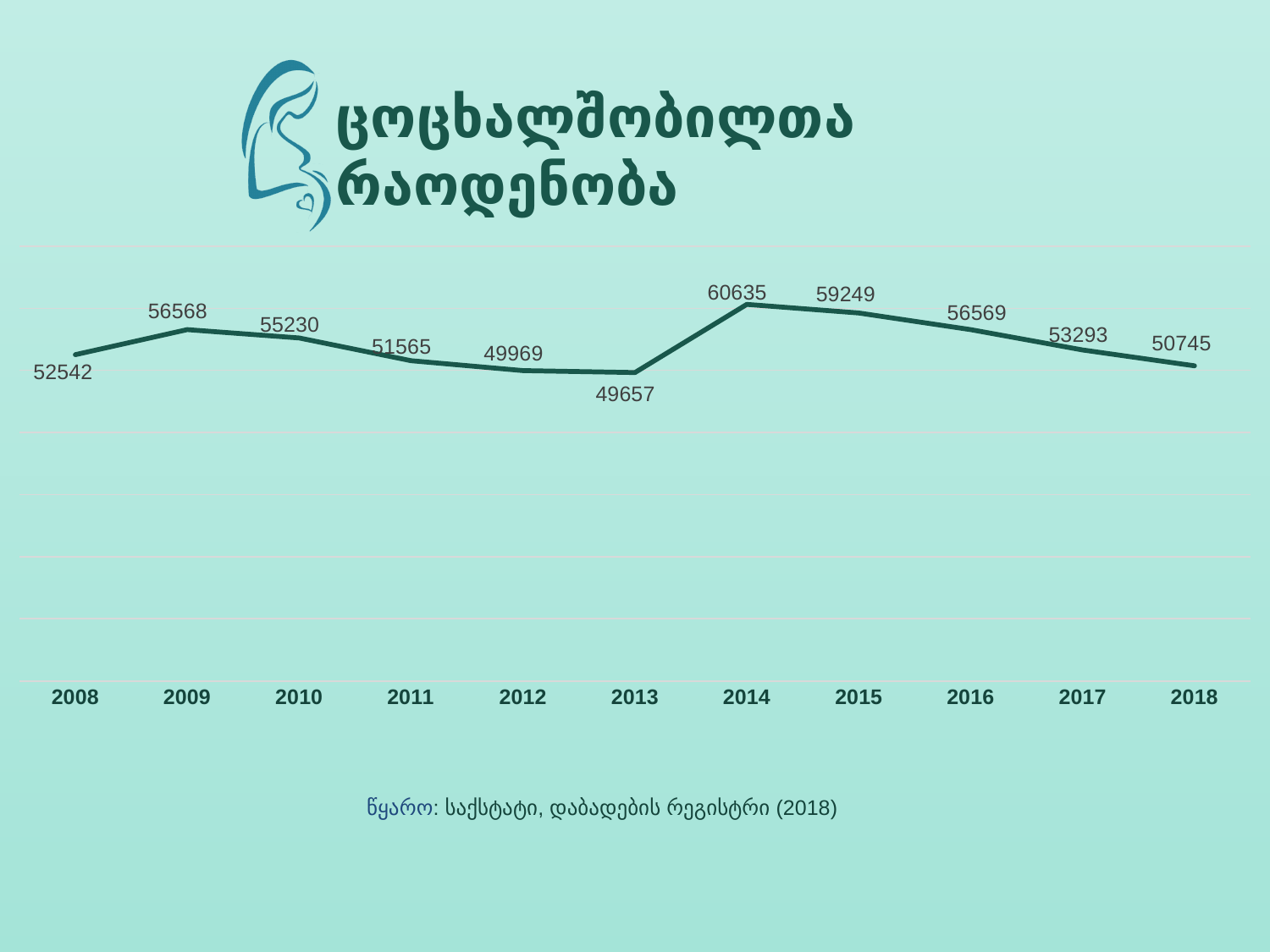
What is the value for 2018? 50745 Do the values rise or fall from 2014 to 2018? fall What is the title of the chart? ცოცხალშობილთა რაოდენობა What is the value for 2014? 60635 What kind of chart is shown on the slide? line chart Which is larger, the value for 2015 or the value for 2017? 2015 What is the value for 2008? 52542 What is the difference between the values for 2009 and 2008? 4026 How many years are plotted on the x axis? 11 What is the difference between the values for 2014 and 2013? 10978 Which year has the lowest value? 2013 Which year has the highest value? 2014